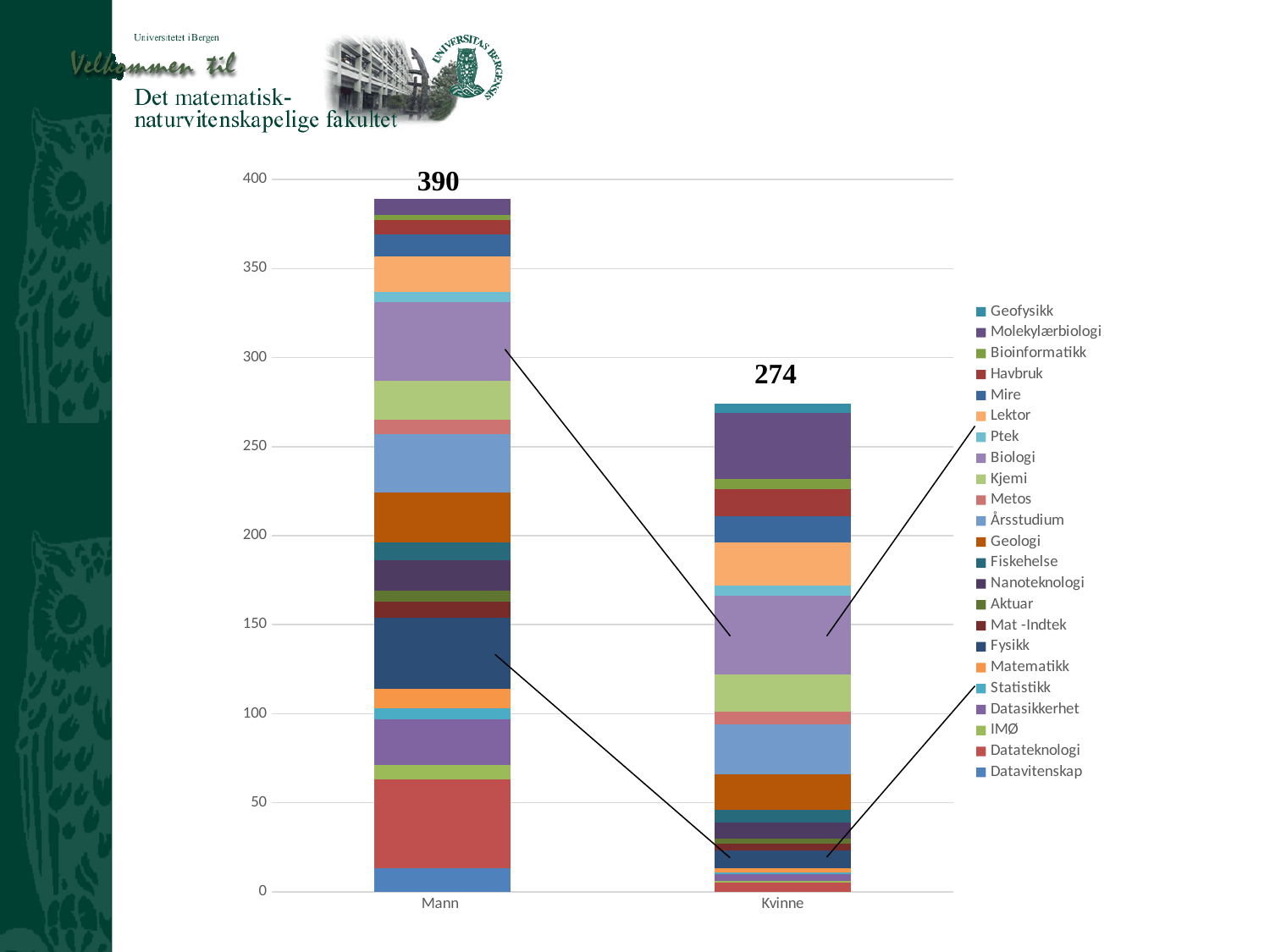
How many categories are shown on the x axis? 2 What is the difference between the Mann total and the Kvinne total? 116 What is the total of the stacked bar for Mann? 390 What is the total of the stacked bar for Kvinne? 274 Which category has the lowest stacked bar total? Kvinne Is the total for Kvinne greater or less than 300? less Which series is listed first (at the top) in the legend? Geofysikk Which series is listed last (at the bottom) in the legend? Datavitenskap Which category has the highest stacked bar total? Mann What kind of chart is shown on the slide? Stacked bar chart Which category has the higher stacked bar total, Mann or Kvinne? Mann How many series does the legend list? 23